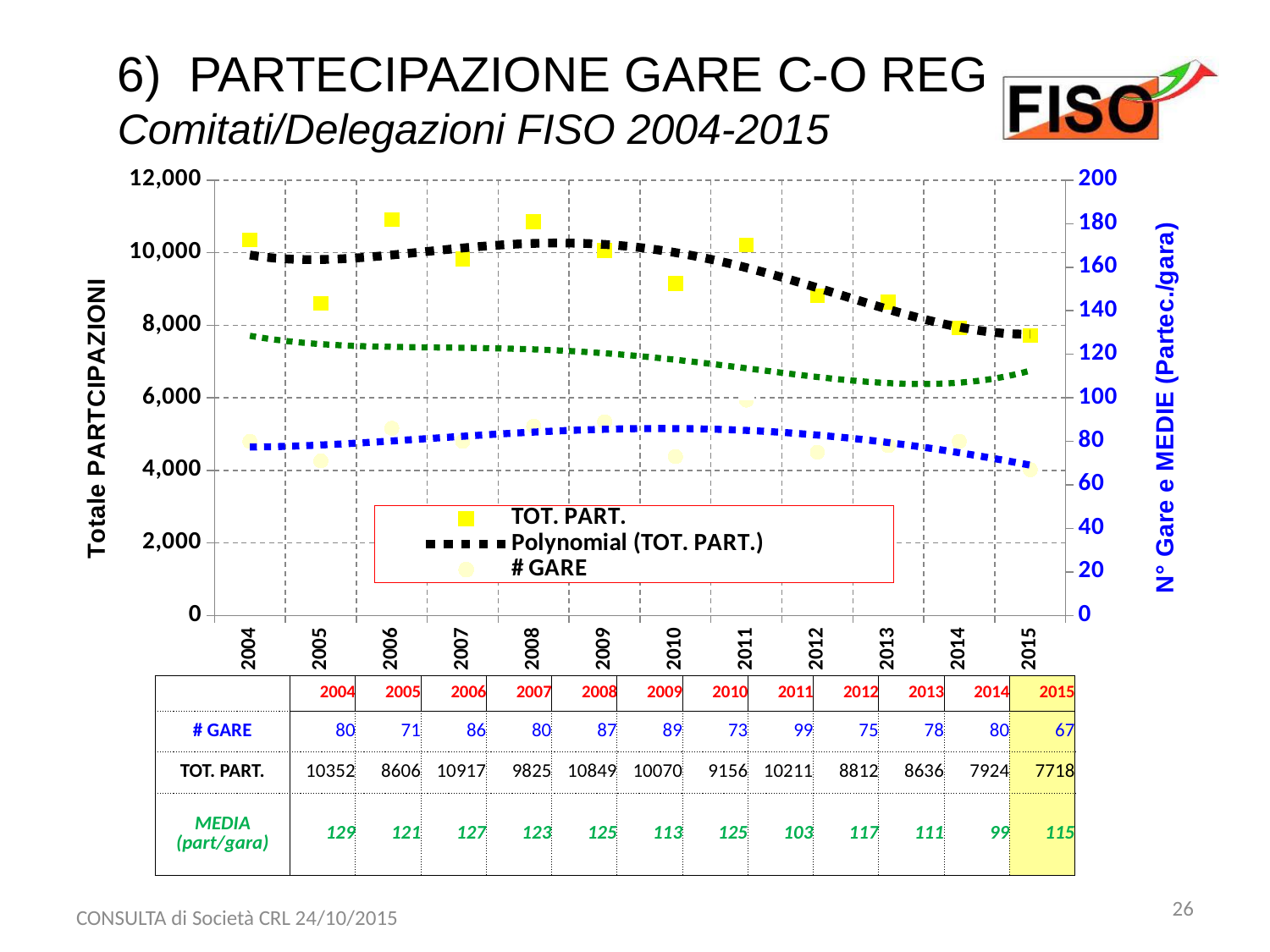
What is the TOT. PART. value for 2006? 10917 What is the # GARE value for 2011? 99 What is the MEDIA (part/gara) value for 2014? 99 Do the TOT. PART. values rise or fall from 2011 to 2015? fall Which year has the lowest TOT. PART. value? 2015 Which year has the lowest # GARE value? 2015 Is the TOT. PART. value for 2010 greater or less than 10,000? less How many years are shown on the x axis of the chart? 12 Which year has the highest # GARE value? 2011 What is the difference between the TOT. PART. values for 2004 and 2015? 2634 Which year has the larger # GARE value, 2008 or 2009? 2009 Which year has the highest TOT. PART. value? 2006